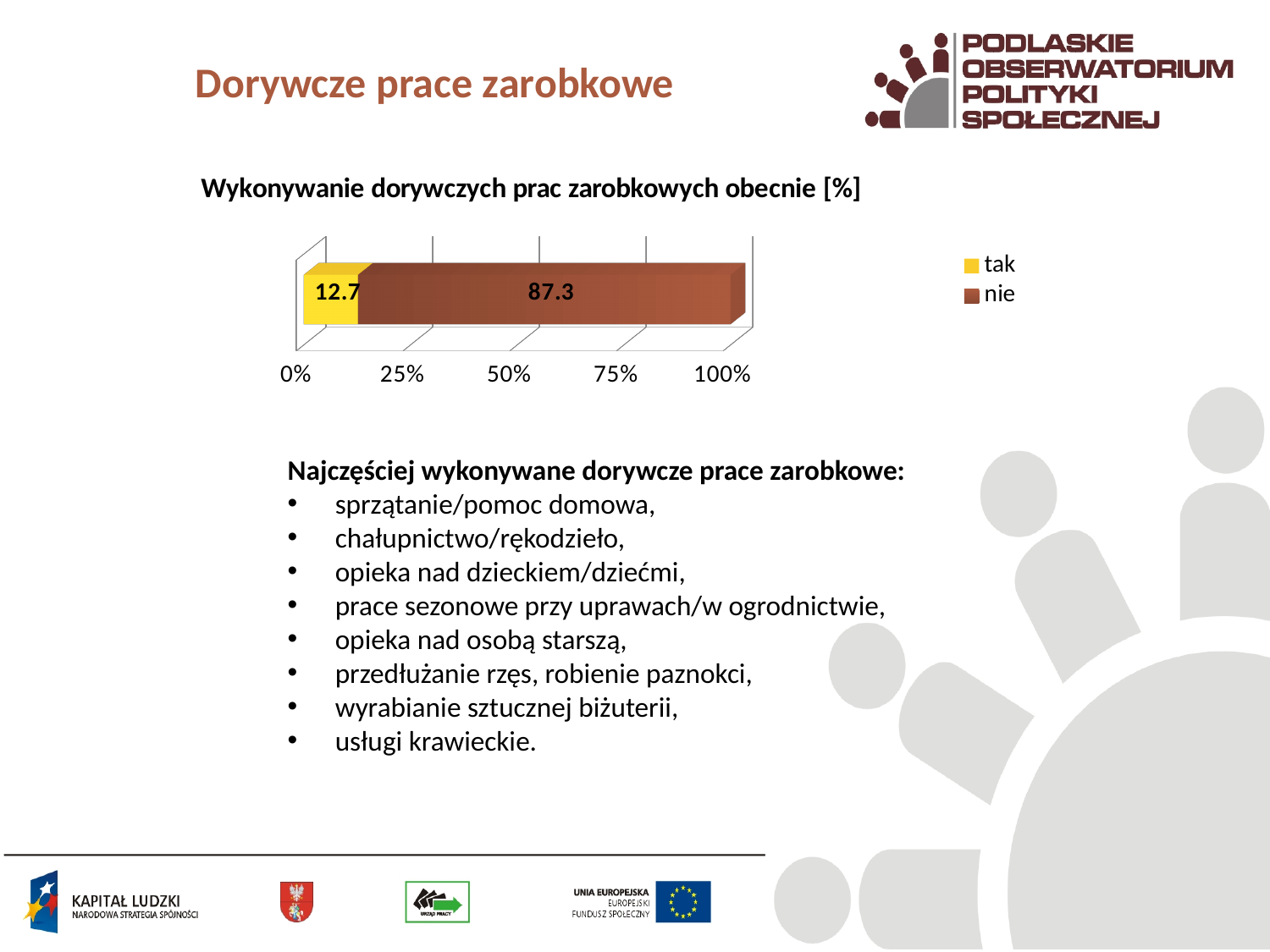
What is the value for "tak" in the chart? 12.7 What is the value for "nie" in the chart? 87.3 What is the total of the stacked bar? 100 Is the value for "nie" greater or less than 75%? greater What kind of chart is shown on the slide? stacked bar chart What is the title of the chart? Wykonywanie dorywczych prac zarobkowych obecnie [%] Which series has the larger value, "tak" or "nie"? nie Which series has the smallest value in the chart? tak How many series does the legend list? 2 What is the difference between the values for "nie" and "tak"? 74.6 What colour represents the "tak" series in the chart? yellow Is the value for "tak" greater or less than 25%? less